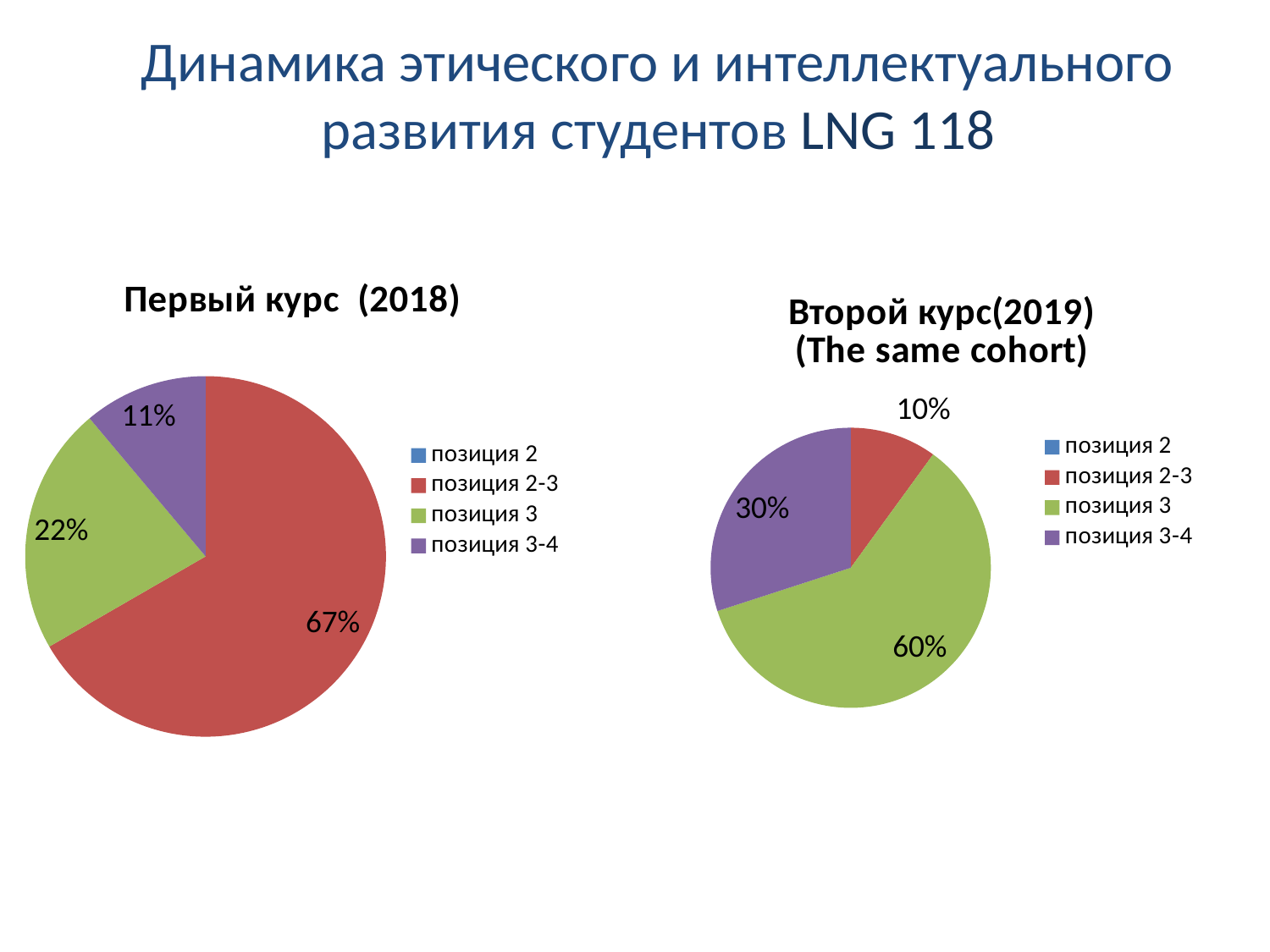
In the chart titled "Первый курс (2018)", what share does "позиция 3" have? 22% In the chart titled "Первый курс (2018)", what is the difference between the shares of "позиция 3" and "позиция 3-4"? 11% In the chart titled "Второй курс(2019) (The same cohort)", which is larger: the share of "позиция 3" or the share of "позиция 3-4"? позиция 3 In the chart titled "Первый курс (2018)", what share does "позиция 3-4" have? 11% In the chart titled "Второй курс(2019) (The same cohort)", what share does "позиция 3" have? 60% In the chart titled "Второй курс(2019) (The same cohort)", what share does "позиция 2-3" have? 10% In the chart titled "Первый курс (2018)", what share does "позиция 2-3" have? 67% How many entries does the legend of the chart titled "Второй курс(2019) (The same cohort)" list? 4 In the chart titled "Второй курс(2019) (The same cohort)", what share does "позиция 3-4" have? 30% In the chart titled "Второй курс(2019) (The same cohort)", which category has the smallest slice? позиция 2-3 In the chart titled "Первый курс (2018)", which category has the largest slice? позиция 2-3 What kind of chart is the chart titled "Первый курс (2018)"? pie chart